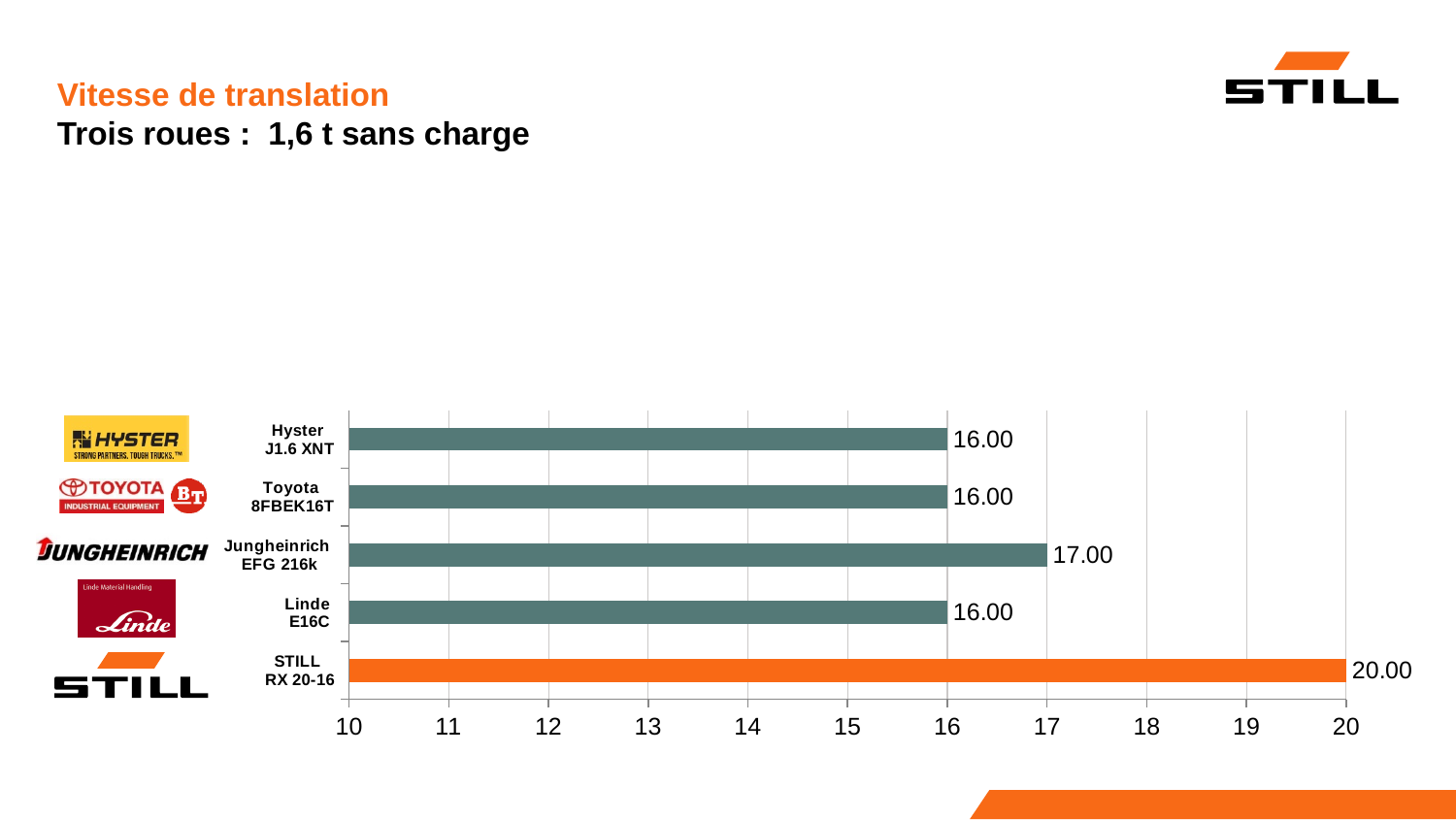
What is the value for Linde E16C? 16.00 Is the value for STILL RX 20-16 greater or less than 18? greater How many categories are shown in the chart? 5 What is the value for Hyster J1.6 XNT? 16.00 Which category has the highest value? STILL RX 20-16 Which is larger, the value for Jungheinrich EFG 216k or the value for Linde E16C? Jungheinrich EFG 216k What is the value for STILL RX 20-16? 20.00 What kind of chart is shown on the slide? bar chart Which bar is coloured orange rather than grey-green? STILL RX 20-16 What is the difference between the values for Jungheinrich EFG 216k and Toyota 8FBEK16T? 1.00 What is the value for Jungheinrich EFG 216k? 17.00 What is the difference between the values for STILL RX 20-16 and Jungheinrich EFG 216k? 3.00